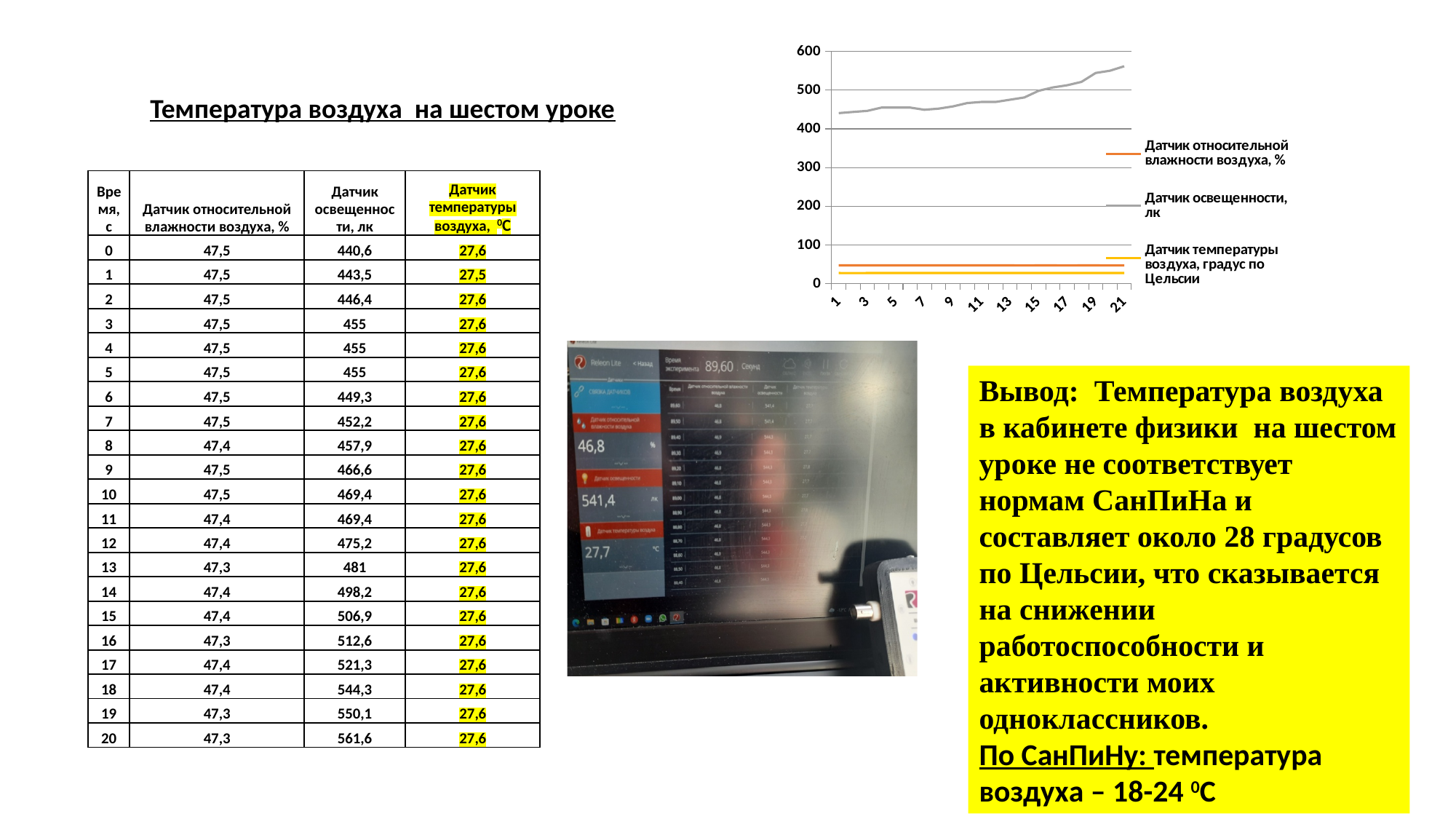
What colour is the line for 'Датчик освещенности, лк' in the chart? gray Which series has the lowest values on the chart? Датчик температуры воздуха, градус по Цельсии Which series has the highest values on the chart? Датчик освещенности, лк Is the value of 'Датчик относительной влажности воздуха, %' at x = 1 greater or less than 100? less What is the highest value labelled on the chart's y axis? 600 How many series does the chart's legend list? 3 Is the value of 'Датчик освещенности, лк' at x = 11 greater or less than 500? less Does the 'Датчик освещенности, лк' series rise or fall along the x axis? rise What kind of chart is shown on the slide? line chart Which series is larger at x = 21: 'Датчик освещенности, лк' or 'Датчик относительной влажности воздуха, %'? Датчик освещенности, лк Is the value of 'Датчик освещенности, лк' at x = 21 greater or less than 500? greater